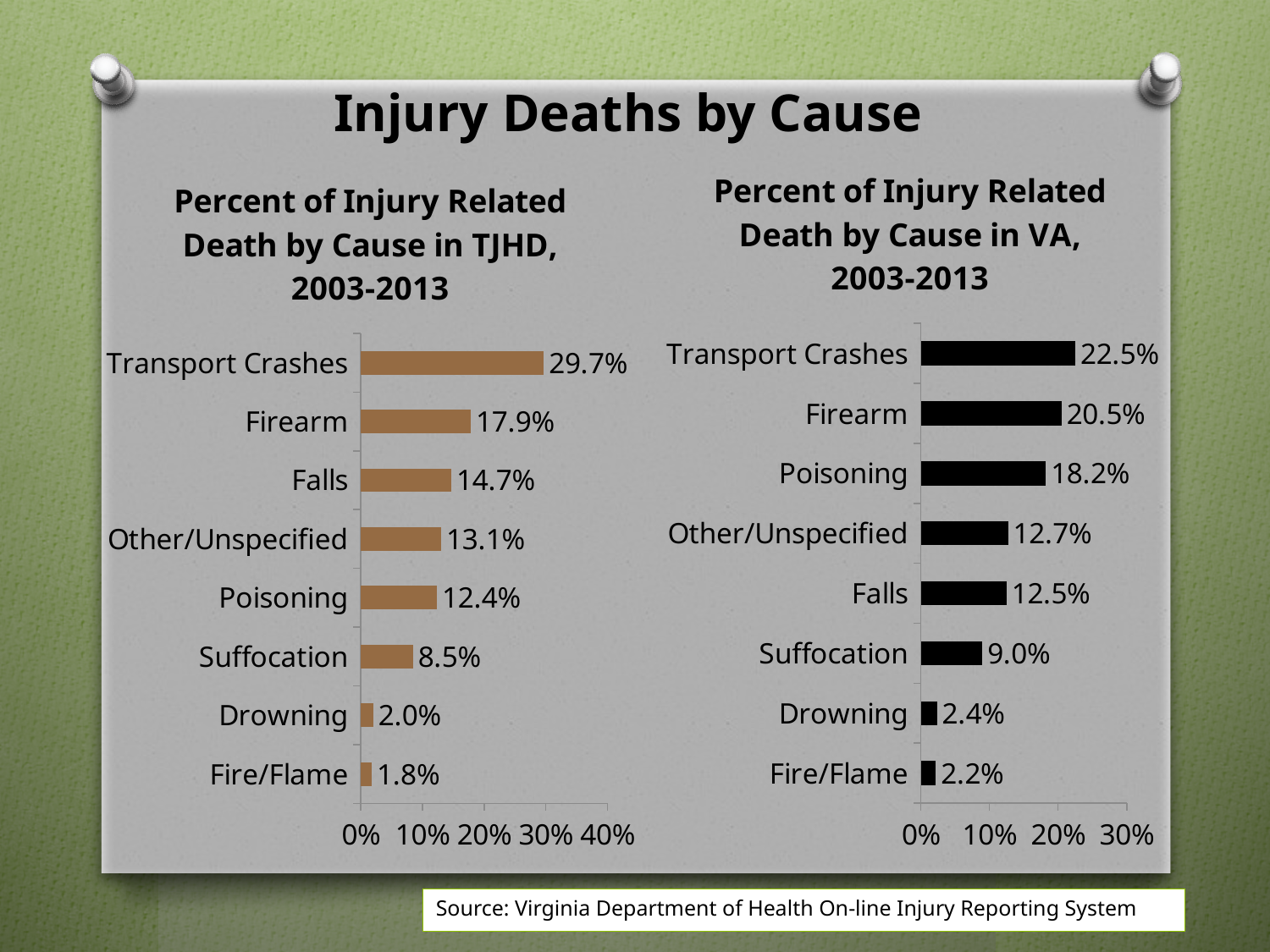
In the TJHD chart, which cause has the lowest percentage? Fire/Flame In the TJHD chart, which is larger, Falls or Poisoning? Falls In the VA chart, what is the value for Poisoning? 18.2% In the TJHD chart, what is the value for Transport Crashes? 29.7% How many causes are shown in the VA chart? 8 What is the title of the chart on the right? Percent of Injury Related Death by Cause in VA, 2003-2013 In the VA chart, which cause has the highest percentage? Transport Crashes In the VA chart, what is the difference between Firearm and Poisoning? 2.3% In the VA chart, is the value for Transport Crashes greater or less than 20%? greater In the TJHD chart, what is the difference between Transport Crashes and Firearm? 11.8% In the TJHD chart, what is the value for Suffocation? 8.5% What kind of chart is the TJHD chart? bar chart